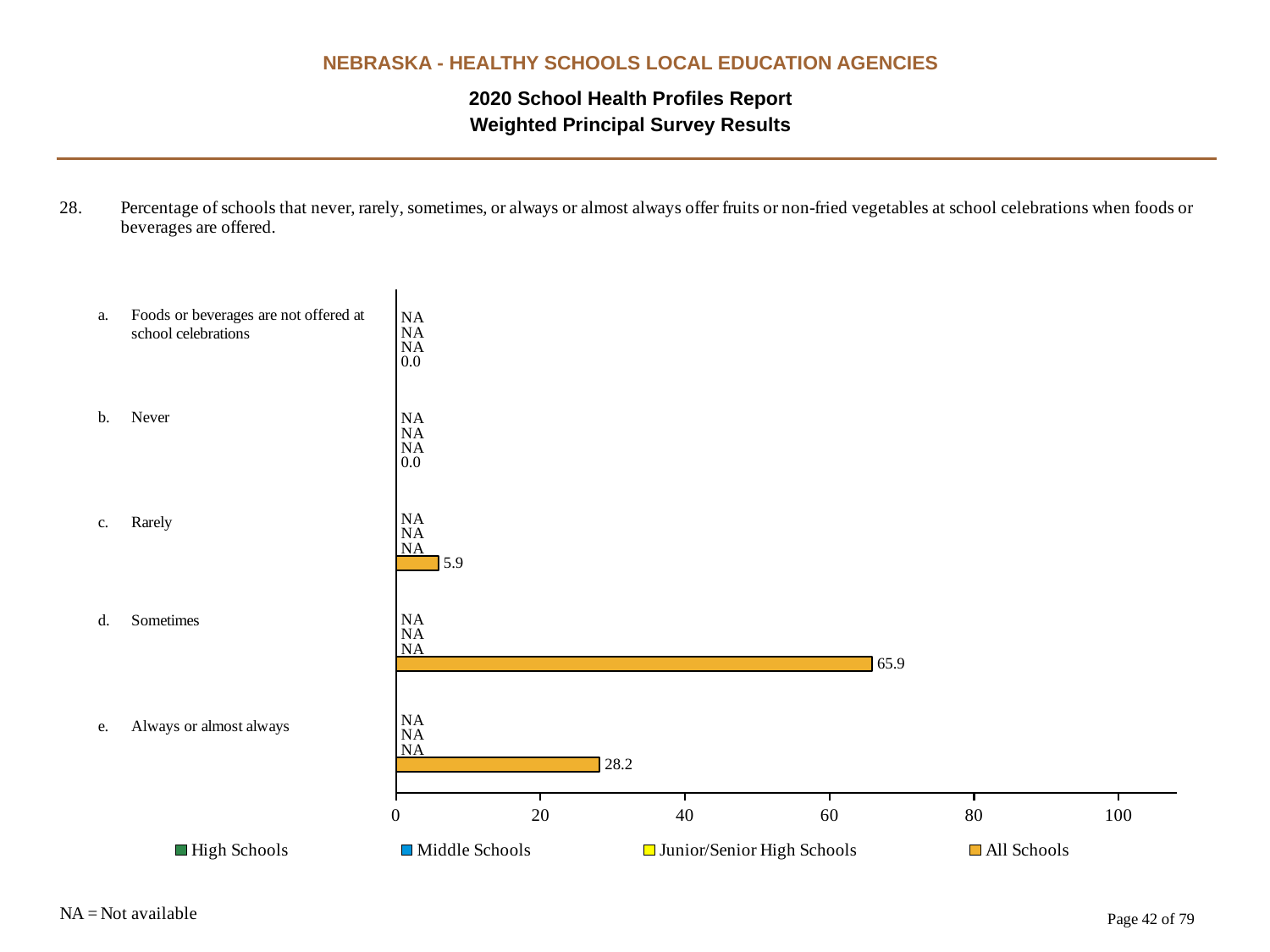
What kind of chart is shown on the slide? bar chart What is the All Schools value for "Never"? 0.0 What is the All Schools value for "Always or almost always"? 28.2 What is the difference between the All Schools values for "Sometimes" and "Always or almost always"? 37.7 What is the High Schools value shown for "Sometimes"? NA What is the All Schools value for "Rarely"? 5.9 What is the All Schools value for "Sometimes"? 65.9 Which category has the highest All Schools value? Sometimes Is the All Schools value for "Sometimes" greater or less than 60? greater How many series does the legend list? 4 Which is larger for All Schools: "Rarely" or "Always or almost always"? Always or almost always How many response categories are shown on the chart? 5